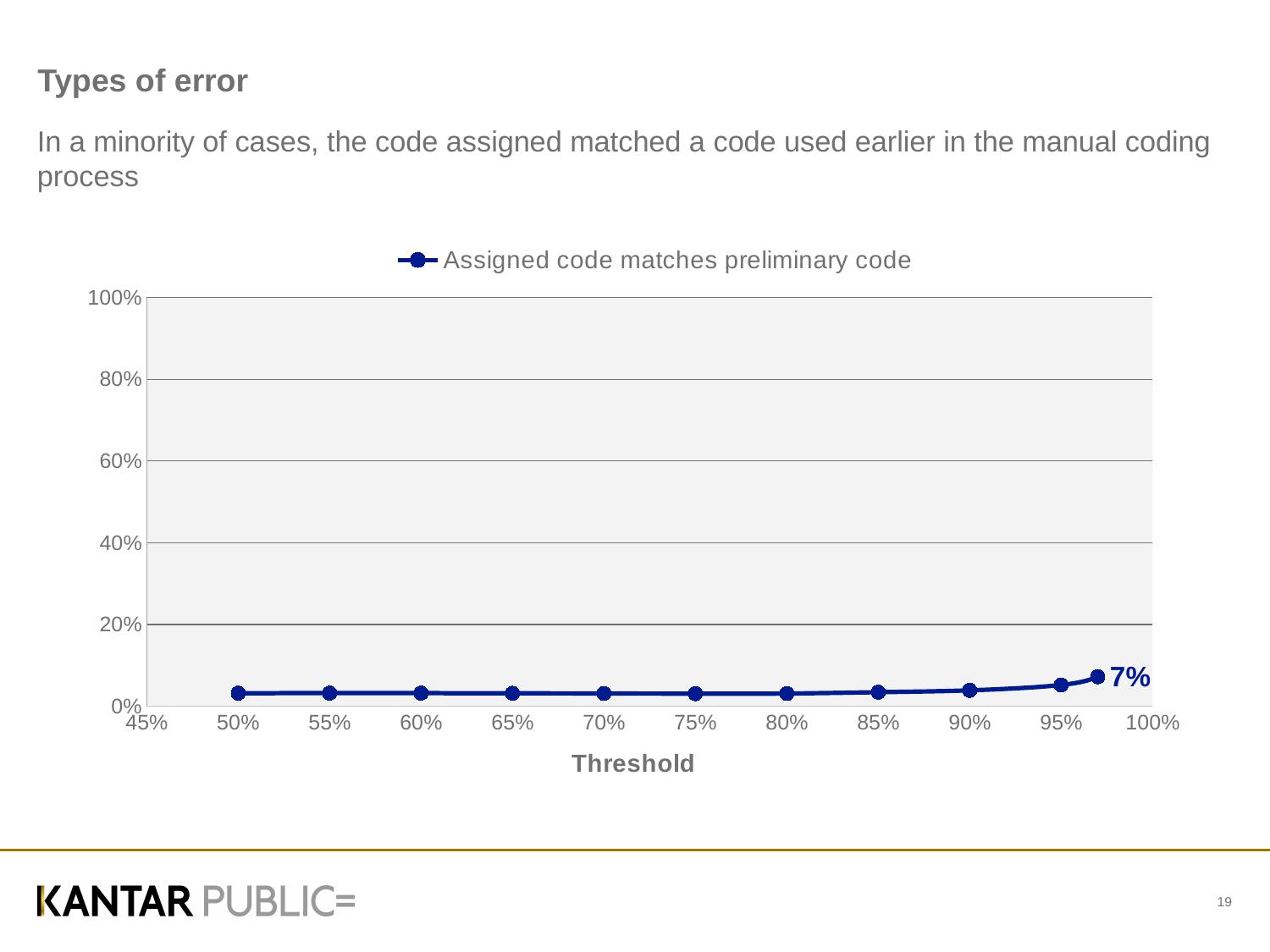
Do the values rise or fall as the threshold increases along the x axis? rise What is the title of the x axis? Threshold What is the highest value shown on the y axis? 100% How many data points are plotted on the line? 11 Is the value at the 50% threshold greater or less than 20%? less Which is larger: the value at the final labelled point or the value at the 50% threshold? the final labelled point What kind of chart is shown on the slide? line chart Is the value at the 90% threshold greater or less than 20%? less What is the name of the series shown in the legend? Assigned code matches preliminary code What value is printed as the data label at the final point of the line? 7% How many series does the legend list? 1 At which point along the line is the value highest? the final point, labelled 7%